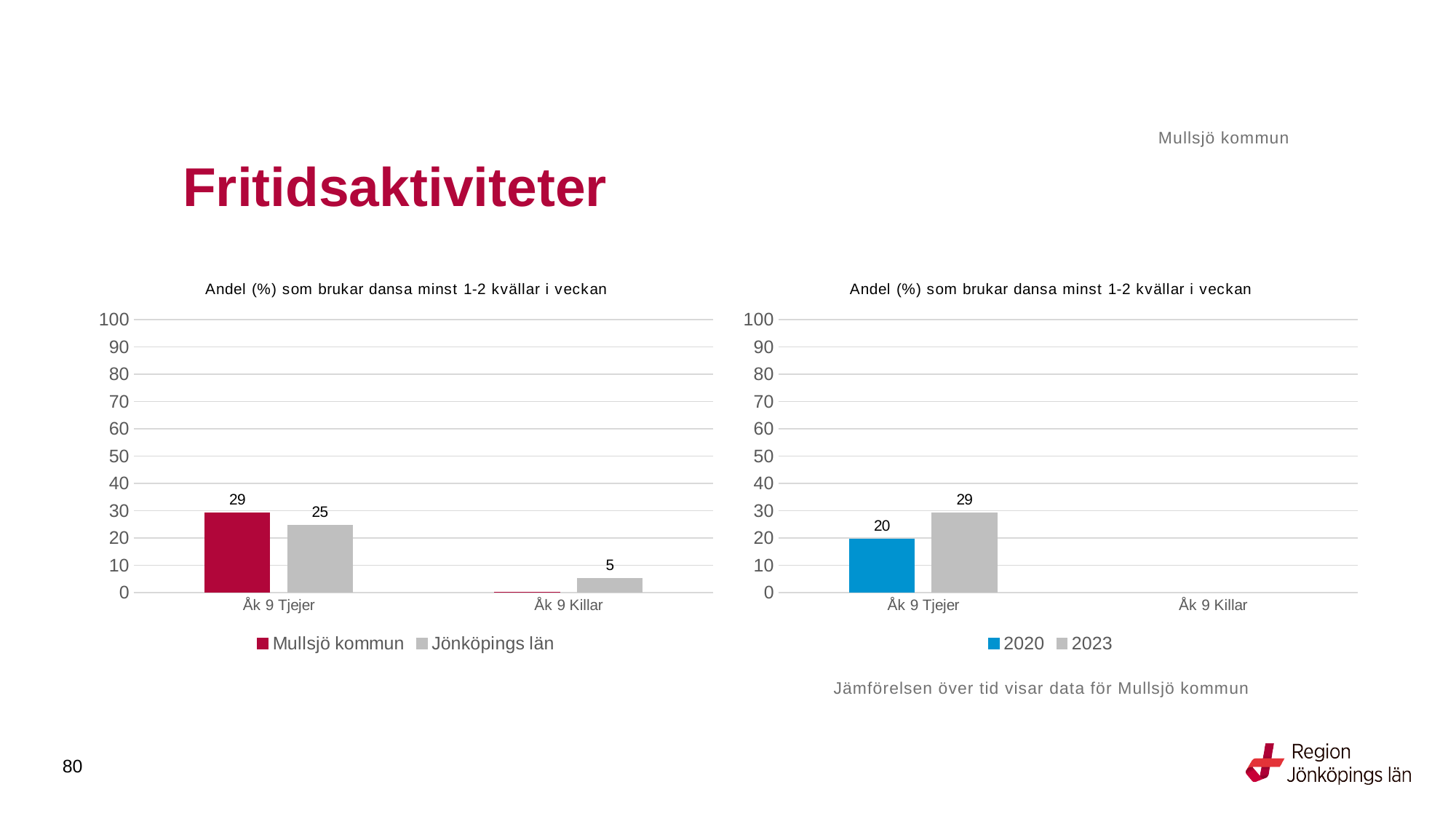
What is the title of the left chart? Andel (%) som brukar dansa minst 1-2 kvällar i veckan In the left chart, what is the value for Jönköpings län for Åk 9 Killar? 5 In the right chart, what is the value for 2023 for Åk 9 Tjejer? 29 In the left chart, what is the value for Mullsjö kommun for Åk 9 Tjejer? 29 In the left chart, what is the difference between Mullsjö kommun and Jönköpings län for Åk 9 Tjejer? 4 In the left chart, what is the value for Jönköpings län for Åk 9 Tjejer? 25 In the left chart, how many series does the legend list? 2 In the right chart, what is the value for 2020 for Åk 9 Tjejer? 20 In the right chart, which year has the higher value for Åk 9 Tjejer? 2023 In the right chart, what is the difference between 2023 and 2020 for Åk 9 Tjejer? 9 What kind of chart is the right chart? Bar chart In the left chart, which is larger for Åk 9 Tjejer: Mullsjö kommun or Jönköpings län? Mullsjö kommun